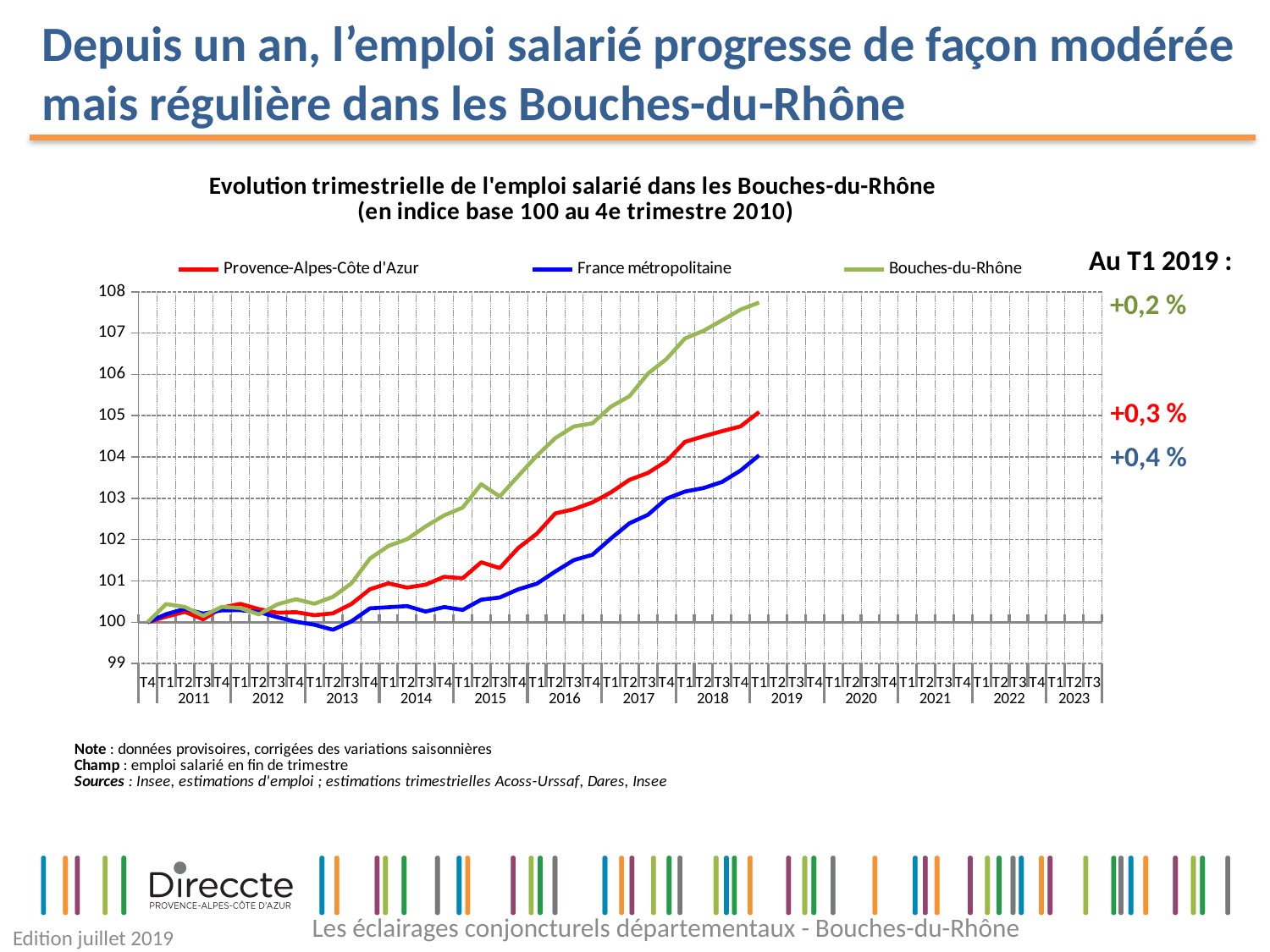
What kind of chart is shown on the slide? line chart How many series does the legend list? 3 Do the index values for Bouches-du-Rhône generally rise or fall from T4 2010 to T1 2019? rise According to the annotation, what is the quarterly change for France métropolitaine at T1 2019? +0,4 % Which series has the lowest index value at T1 2019? France métropolitaine At T1 2019, which series has the larger index value: Provence-Alpes-Côte d'Azur or France métropolitaine? Provence-Alpes-Côte d'Azur According to the annotation, what is the quarterly change for Bouches-du-Rhône at T1 2019? +0,2 % Which series has the highest index value at T1 2019? Bouches-du-Rhône Which colour represents Bouches-du-Rhône in the chart? green Is the index value for France métropolitaine at T1 2019 greater or less than 103? greater Is the index value for Bouches-du-Rhône at T1 2019 greater or less than 107? greater Is the index value for Provence-Alpes-Côte d'Azur at T1 2019 greater or less than 104? greater